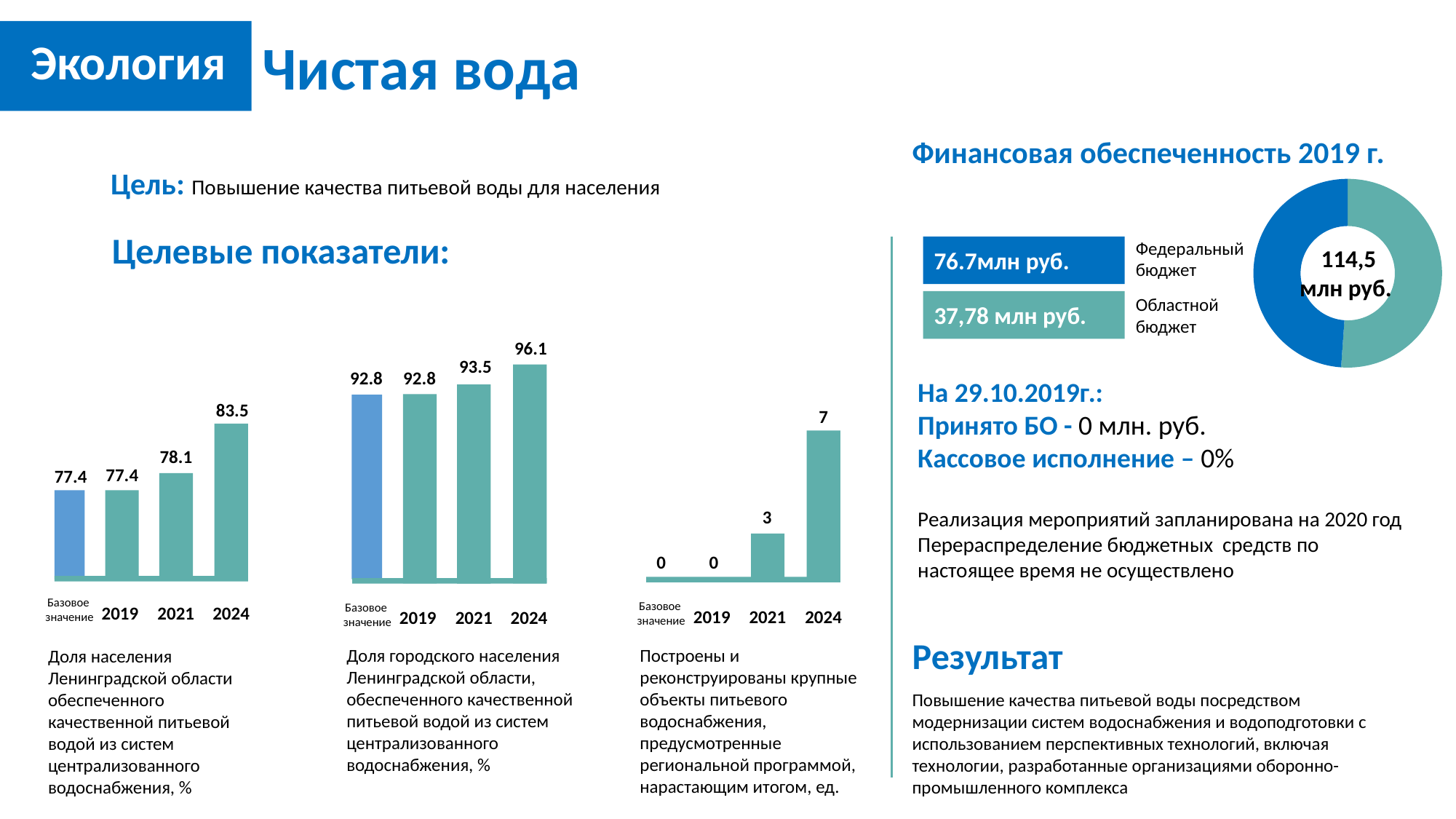
In the right bar chart, what is the value for 2024? 7 In the right bar chart, how many categories are shown on the x axis? 4 In the donut chart under 'Финансовая обеспеченность 2019 г.', what is the amount for the federal budget (Федеральный бюджет)? 76.7млн руб. In the left bar chart, what is the value for 2021? 78.1 In the middle bar chart, what is the base value (Базовое значение)? 92.8 In the donut chart under 'Финансовая обеспеченность 2019 г.', what total is shown in the centre? 114,5 млн руб. In the right bar chart (large drinking water supply facilities built and reconstructed), what is the value for 2021? 3 In the middle bar chart (share of urban population supplied with quality drinking water), what is the value for 2024? 96.1 In the left bar chart (share of the Leningrad region population supplied with quality drinking water), what is the value for 2024? 83.5 In the middle bar chart, which year has the highest value? 2024 In the left bar chart, what is the difference between the 2024 value and the 2019 value? 6.1 Do the values in the middle bar chart rise or fall from the base value to 2024? rise